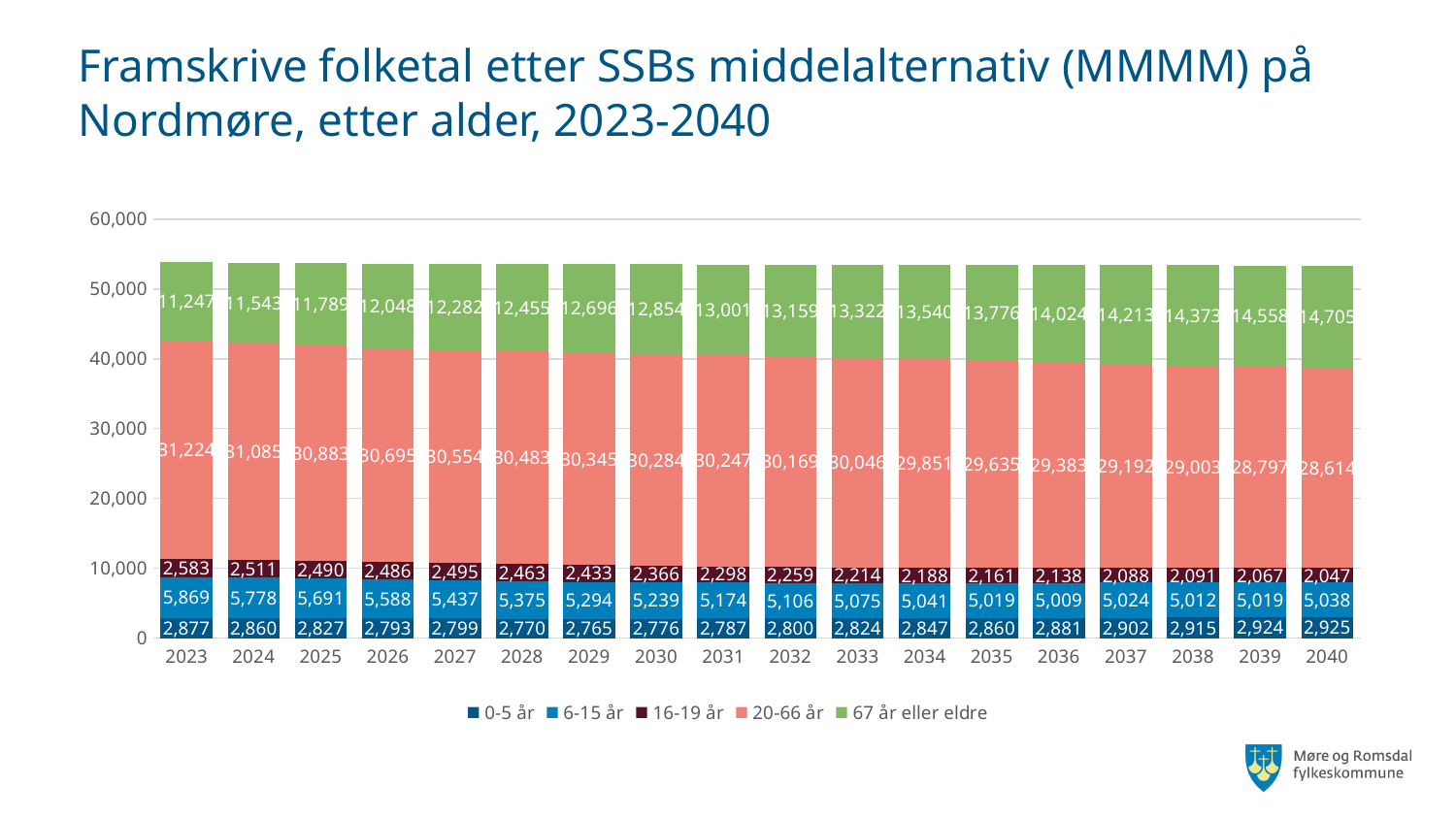
What type of chart is shown on the slide? Stacked bar chart In which year is the 6-15 år group lowest? 2036 In which year is the 67 år eller eldre group highest? 2040 Does the 20-66 år group rise or fall from 2023 to 2040? Fall Which is larger: the 0-5 år value in 2023 or in 2040? 2040 What is the value for the 6-15 år group in 2030? 5,239 How many series does the legend list? 5 What is the value for the 67 år eller eldre group in 2023? 11,247 What is the difference between the 67 år eller eldre value in 2040 and in 2023? 3,458 What is the total of the stacked bar for 2023? 53,800 What is the value for the 20-66 år group in 2040? 28,614 How many years are shown on the x axis? 18